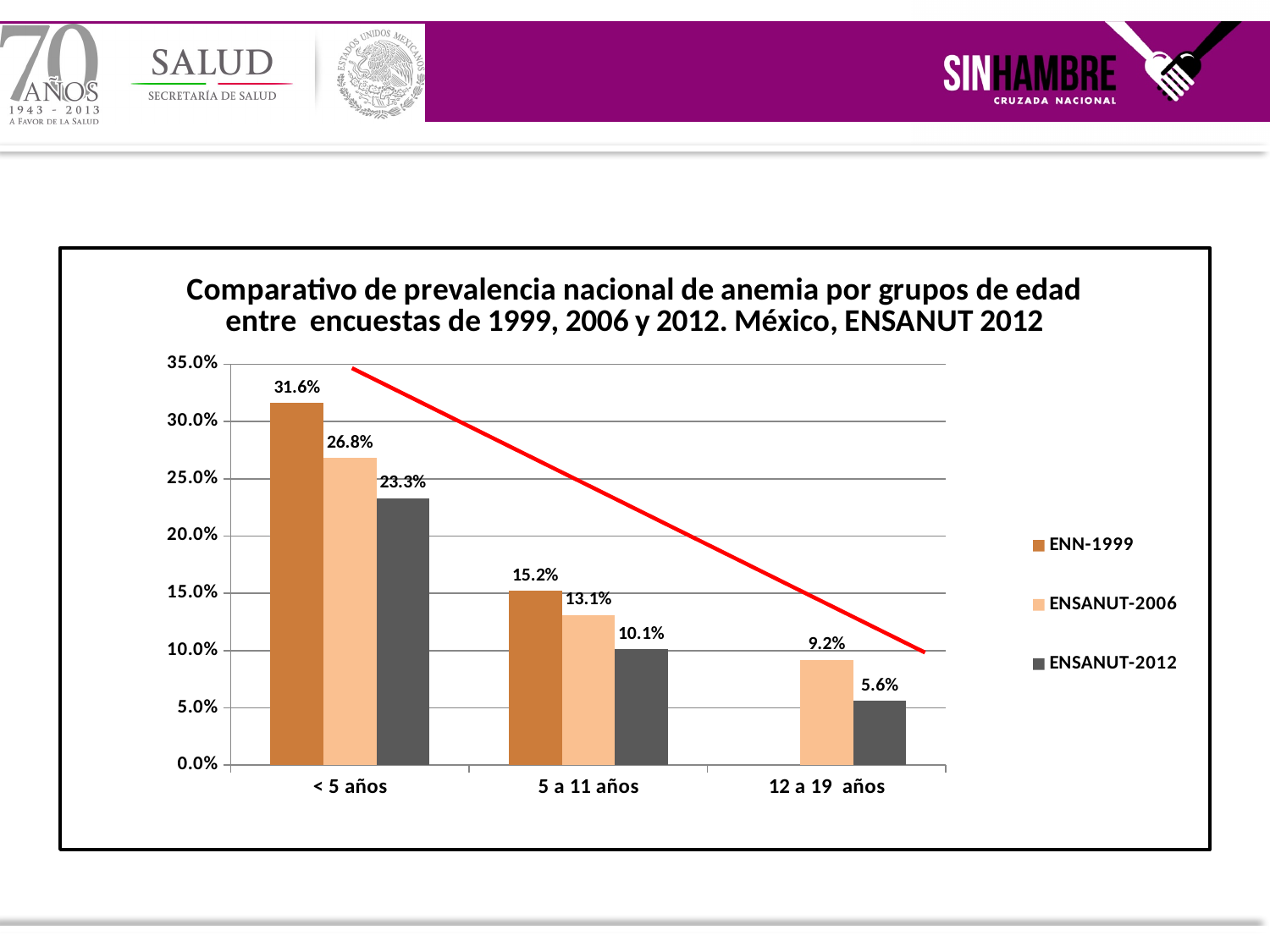
Is the ENSANUT-2006 value for the < 5 años group greater or less than 25.0%? greater What is the difference between the ENN-1999 and ENSANUT-2012 values for the < 5 años group? 8.3% What is the ENSANUT-2006 value for the 12 a 19 años group? 9.2% Which age group has the highest ENSANUT-2012 value? < 5 años Which is larger for the 5 a 11 años group: the ENN-1999 value or the ENSANUT-2006 value? ENN-1999 What is the ENN-1999 value for the < 5 años group? 31.6% What kind of chart is shown on the slide? bar chart How many age groups are shown on the x axis? 3 Do the ENSANUT-2012 values rise or fall from the < 5 años group to the 12 a 19 años group? fall What is the ENSANUT-2012 value for the 5 a 11 años group? 10.1% How many series does the legend list? 3 Which age group has the lowest ENSANUT-2006 value? 12 a 19 años